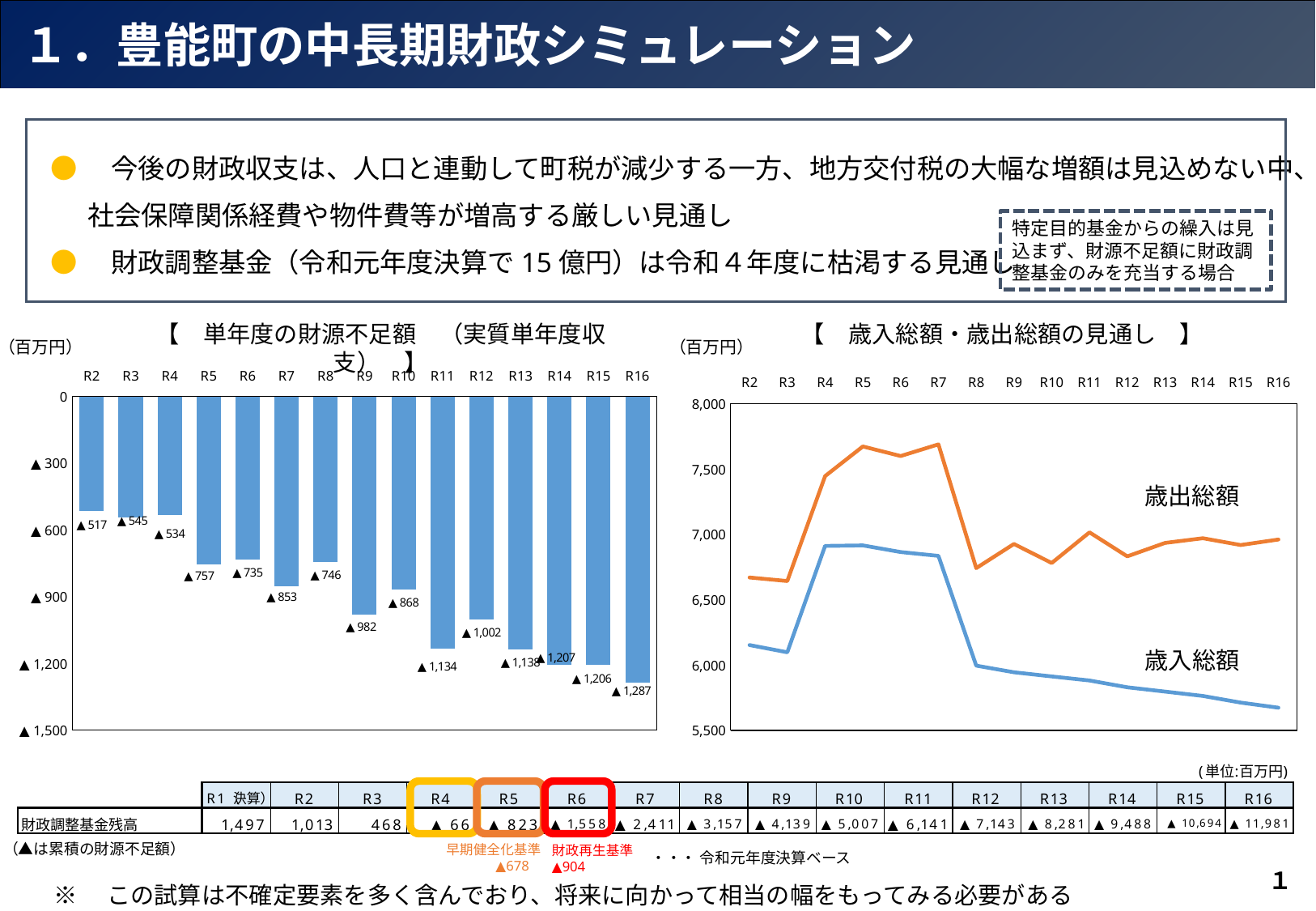
In the right chart 歳入総額・歳出総額の見通し, is the value of 歳入総額 at R16 greater or less than 6,000? less What type of chart is the left chart 単年度の財源不足額? Bar chart In the left chart 単年度の財源不足額, what is the value for R9? ▲982 In the left chart 単年度の財源不足額, what is the value for R16? ▲1,287 In the left chart 単年度の財源不足額, what is the difference between the R16 value (▲1,287) and the R2 value (▲517)? 770 In the right chart 歳入総額・歳出総額の見通し, does 歳入総額 rise or fall from R8 to R16? fall In the left chart 単年度の財源不足額, which year has the smallest deficit (shortest bar)? R2 In the left chart 単年度の財源不足額, which year has the largest deficit (longest bar)? R16 In the right chart 歳入総額・歳出総額の見通し, is the value of 歳出総額 at R5 greater or less than 7,500? greater In the left chart 単年度の財源不足額, what is the value for R2? ▲517 In the left chart 単年度の財源不足額, which bar is longer, R5 or R6? R5 How many years (bars) are shown in the left chart 単年度の財源不足額? 15